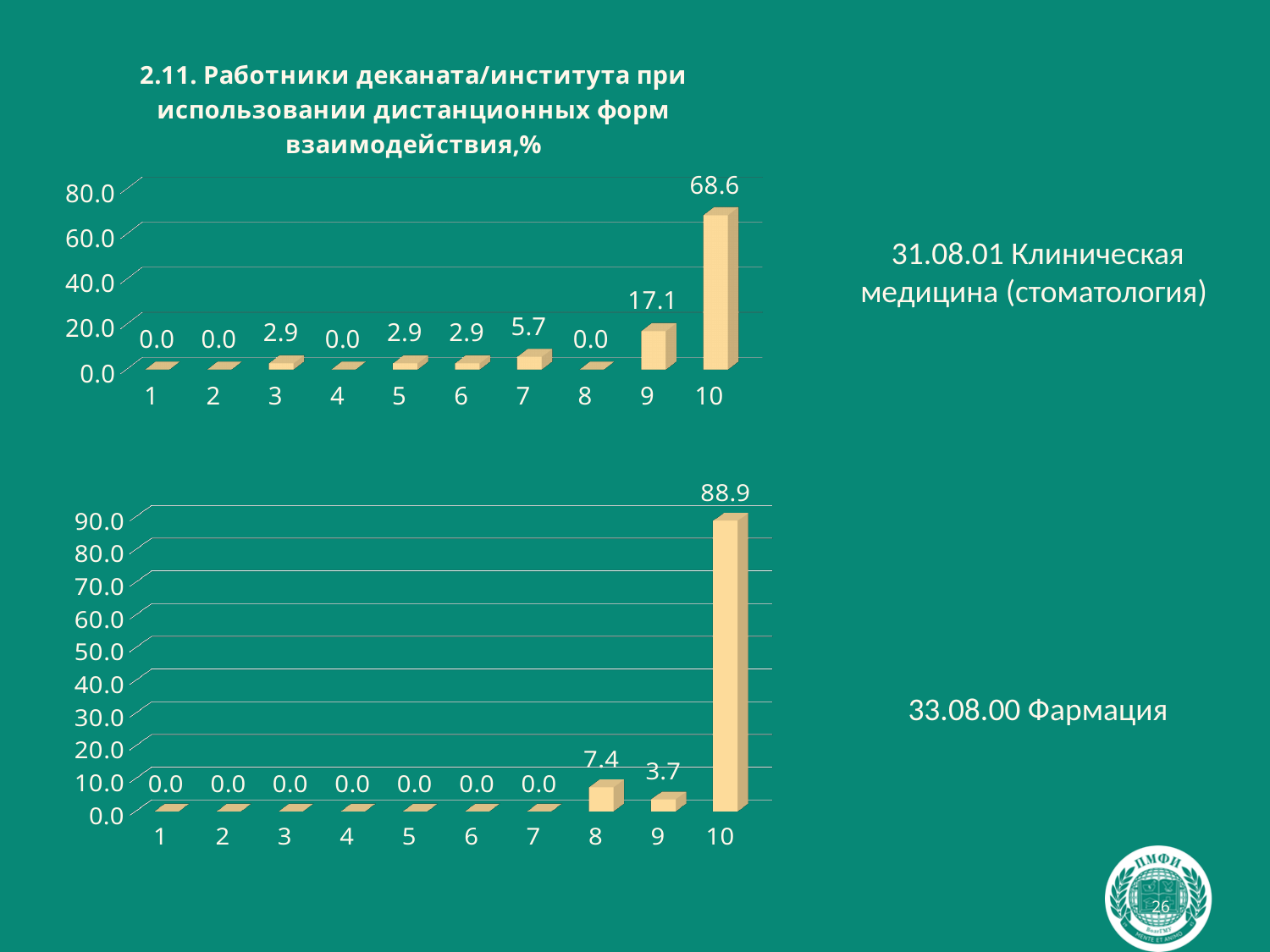
In the top chart (31.08.01 Клиническая медицина (стоматология)), what is the value for category 9? 17.1 In the top chart (31.08.01 Клиническая медицина (стоматология)), what is the value for category 7? 5.7 What type of chart is the top chart on the slide? bar chart In the top chart (31.08.01 Клиническая медицина (стоматология)), how many categories are shown on the x axis? 10 In the top chart (31.08.01 Клиническая медицина (стоматология)), which category has the highest value? 10 In the bottom chart (33.08.00 Фармация), what is the value for category 10? 88.9 In the top chart (31.08.01 Клиническая медицина (стоматология)), what is the difference between the values for categories 10 and 9? 51.5 In the bottom chart (33.08.00 Фармация), how many categories have a value of 0.0? 7 In the bottom chart (33.08.00 Фармация), which is larger, the value for category 8 or category 9? category 8 In the bottom chart (33.08.00 Фармация), what is the value for category 8? 7.4 In the bottom chart (33.08.00 Фармация), what is the difference between the values for categories 8 and 9? 3.7 In the top chart (31.08.01 Клиническая медицина (стоматология)), what is the value for category 10? 68.6